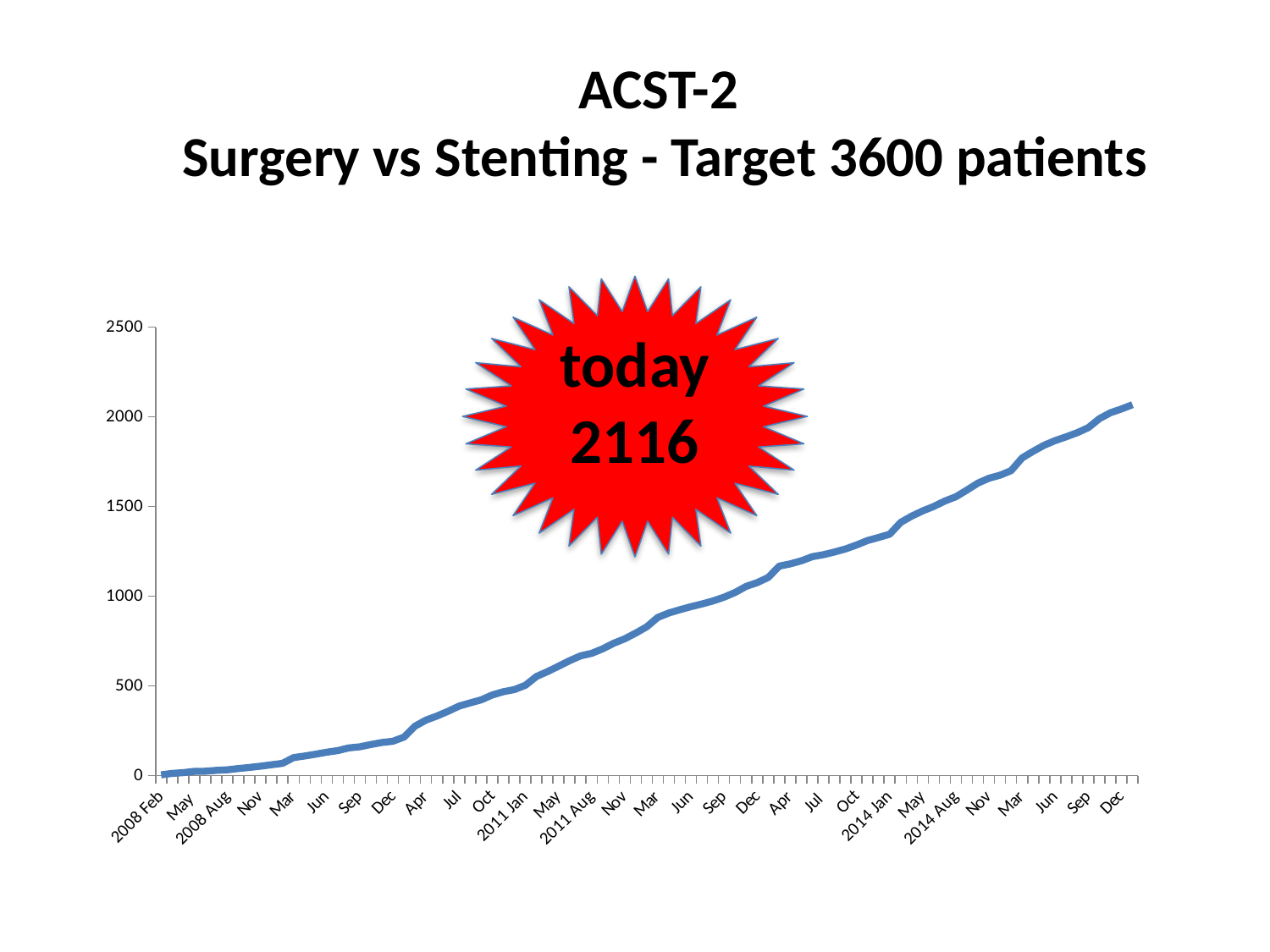
Is the value for 2008 Aug greater or less than 500? less Is the value for the final Dec point greater or less than 2000? greater What number of patients recruited 'today' is shown in the red starburst on the chart? 2116 Is the value for 2014 Jan larger than the value for 2011 Jan? Yes Is the value for the Nov point after 2014 Aug greater or less than 1500? greater Which x-axis category has the lowest value? 2008 Feb Do the values rise or fall along the x axis from 2008 Feb to Dec? rise What kind of chart is shown on the slide? line chart What is the target number of patients stated in the slide title? 3600 patients